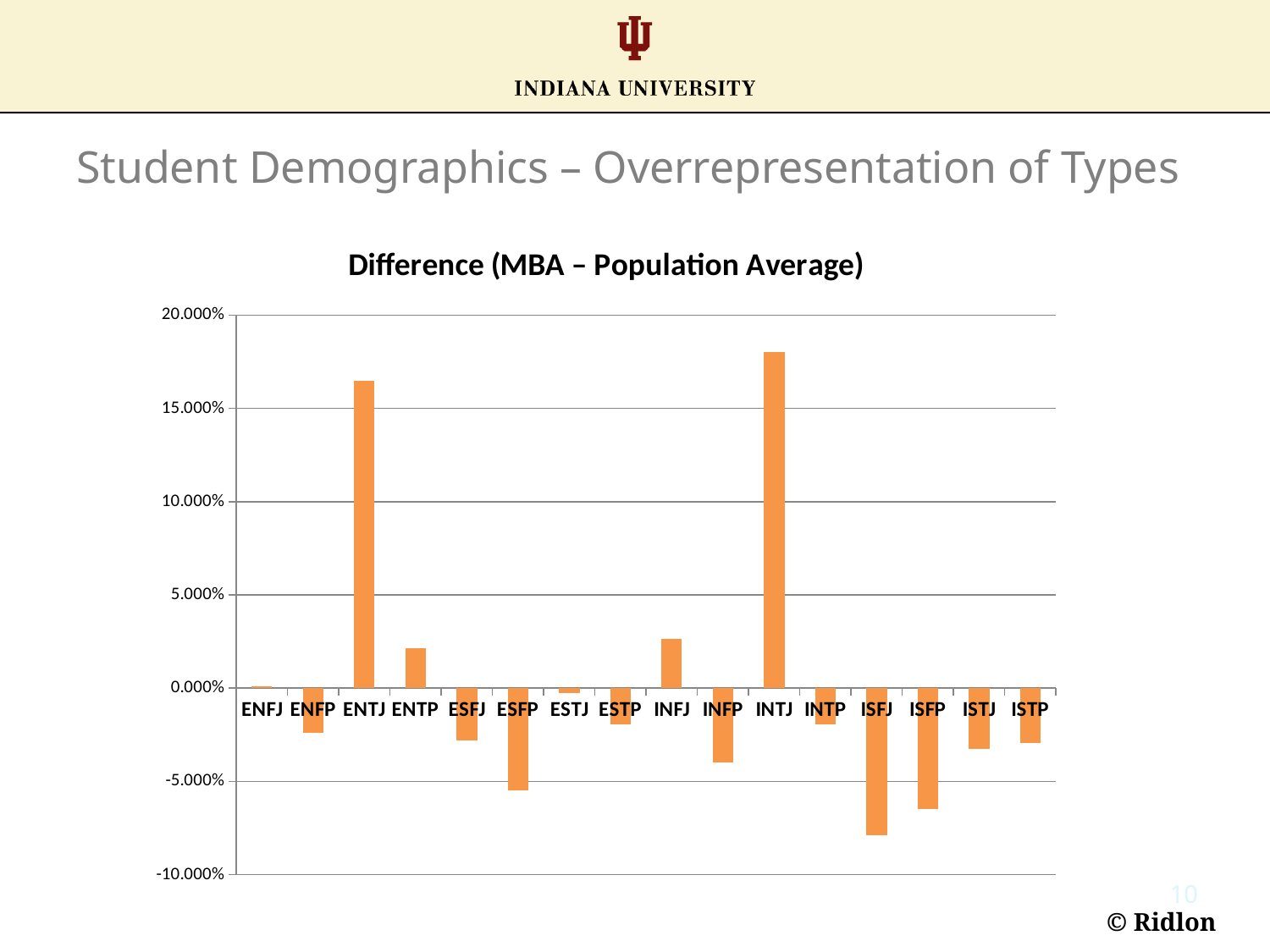
What kind of chart is shown on the slide? bar chart Is the value for ISFJ greater or less than -5.000%? less Which is larger, the value for ENTJ or the value for ENTP? ENTJ Which type has the lowest value? ISFJ Is the value for ENTJ greater or less than 15.000%? greater Is the value for INFP greater or less than 0.000%? less Which is larger, the value for ENTJ or the value for INTJ? INTJ Which type has the highest value? INTJ What is the title of the chart? Difference (MBA – Population Average) How many personality types are plotted on the x axis? 16